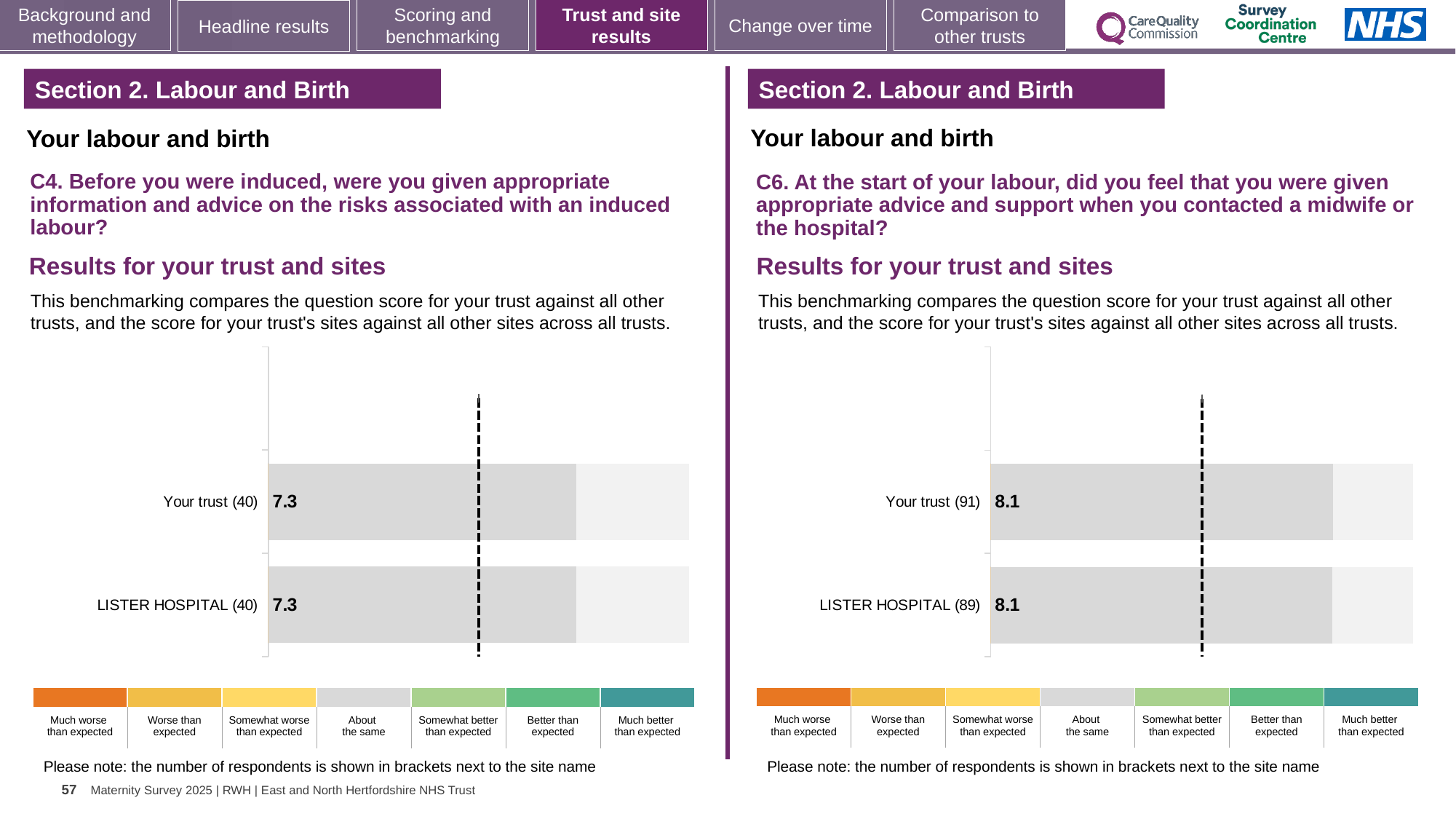
On the left chart (C4), what is the score for Your trust? 7.3 On the right chart (C6), what is the score for LISTER HOSPITAL? 8.1 On the left chart (C4), what is the difference between the score for Your trust and the score for LISTER HOSPITAL? 0.0 On the left chart (C4), how many respondents are shown in brackets for Your trust? 40 On the right chart (C6), how many respondents are shown in brackets for LISTER HOSPITAL? 89 On the right chart (C6), what is the difference between the score for Your trust and the score for LISTER HOSPITAL? 0.0 What kind of chart is used on the left (C4) to show the results for your trust and sites? Bar chart On the left chart (C4), what is the score for LISTER HOSPITAL? 7.3 How many bars are plotted on the left chart (C4)? 2 On the right chart (C6), what is the score for Your trust? 8.1 How many bars are plotted on the right chart (C6)? 2 How many categories does the colour key below the left chart (C4) list, from 'Much worse than expected' to 'Much better than expected'? 7